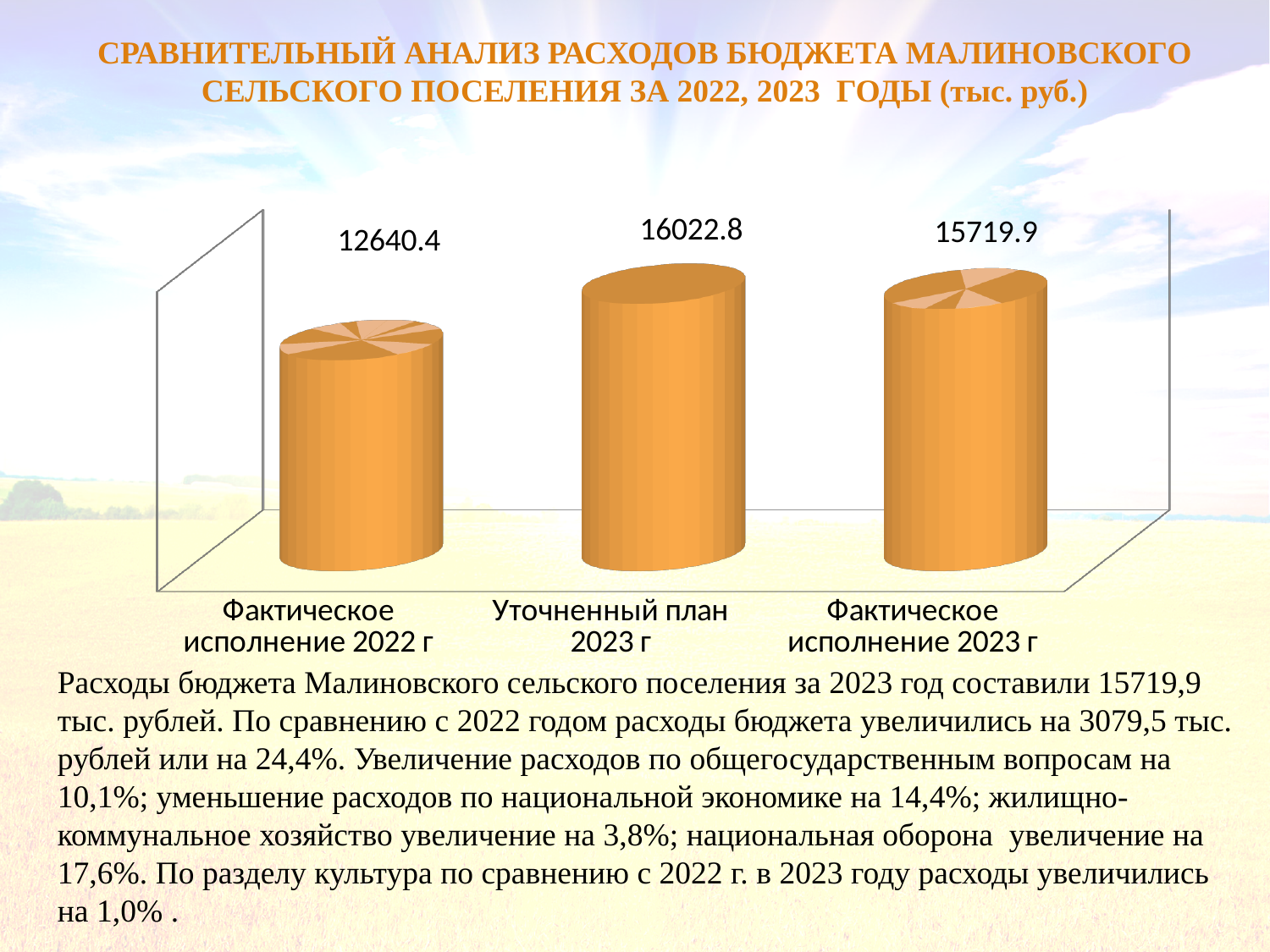
What is the value for Фактическое исполнение 2023 г? 15719.9 What unit is given in the chart title for the values? тыс. руб. What is the difference between Уточненный план 2023 г and Фактическое исполнение 2023 г? 302.9 What kind of chart is shown on the slide? Bar chart What is the value for Фактическое исполнение 2022 г? 12640.4 What is the difference between Уточненный план 2023 г and Фактическое исполнение 2022 г? 3382.4 What is the difference between Фактическое исполнение 2023 г and Фактическое исполнение 2022 г? 3079.5 Which category has the lowest value? Фактическое исполнение 2022 г How many categories are shown in the chart? 3 Which is larger: Фактическое исполнение 2022 г or Фактическое исполнение 2023 г? Фактическое исполнение 2023 г What is the value for Уточненный план 2023 г? 16022.8 Which category has the highest value? Уточненный план 2023 г